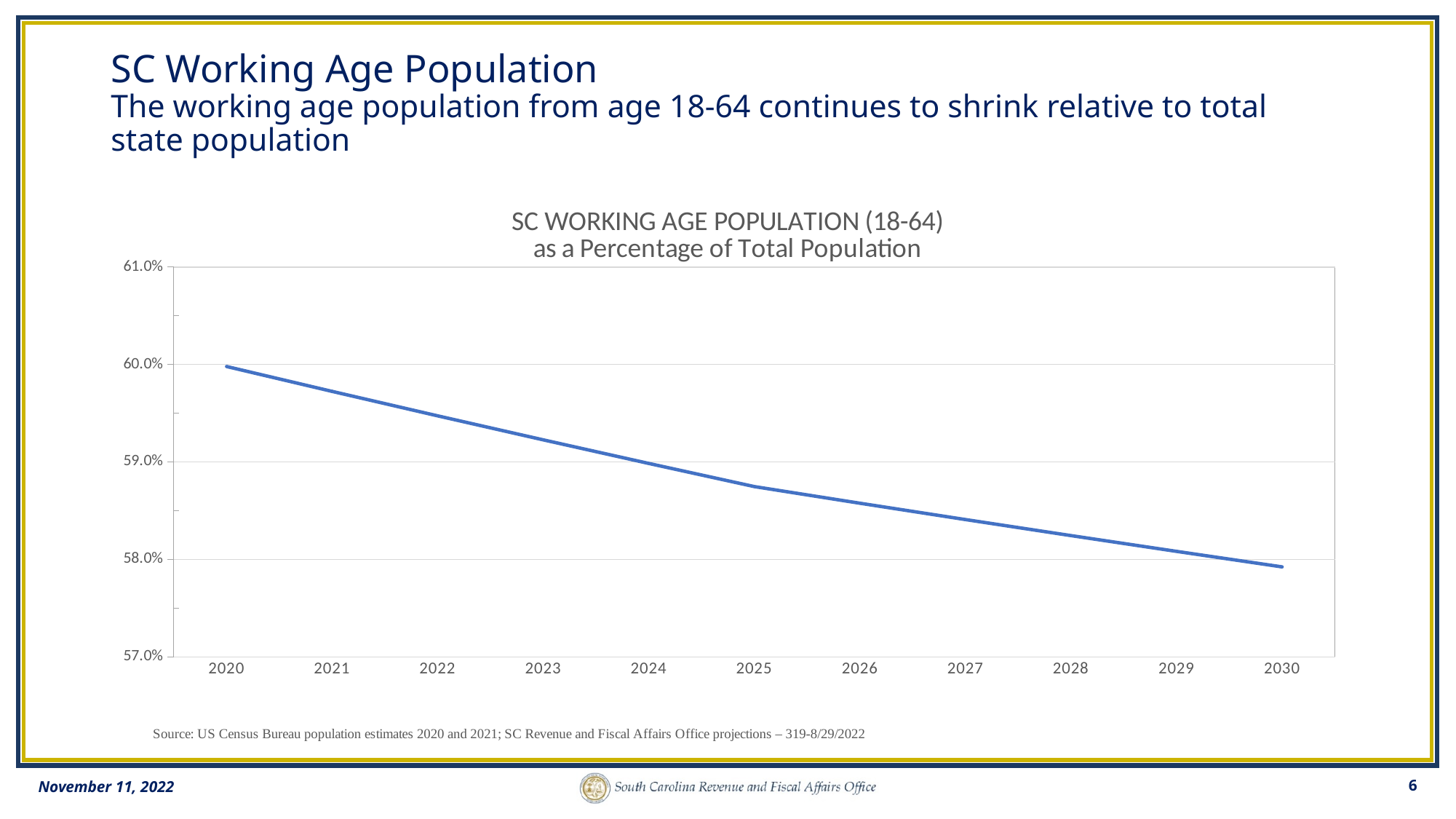
Is the value for 2028 greater or less than 58.0%? greater Do the values in the chart rise or fall from 2020 to 2030? fall What is the title of the chart? SC WORKING AGE POPULATION (18-64) as a Percentage of Total Population How many years are plotted along the x axis of the chart? 11 Which year has the lowest working age population percentage in the chart? 2030 Is the value for 2021 greater or less than 59.0%? greater What kind of chart is shown on the slide? line chart What colour is the line in the chart? blue Is the value for 2022 greater or less than 59.0%? greater Which year has the highest working age population percentage in the chart? 2020 Which year has a larger value, 2023 or 2027? 2023